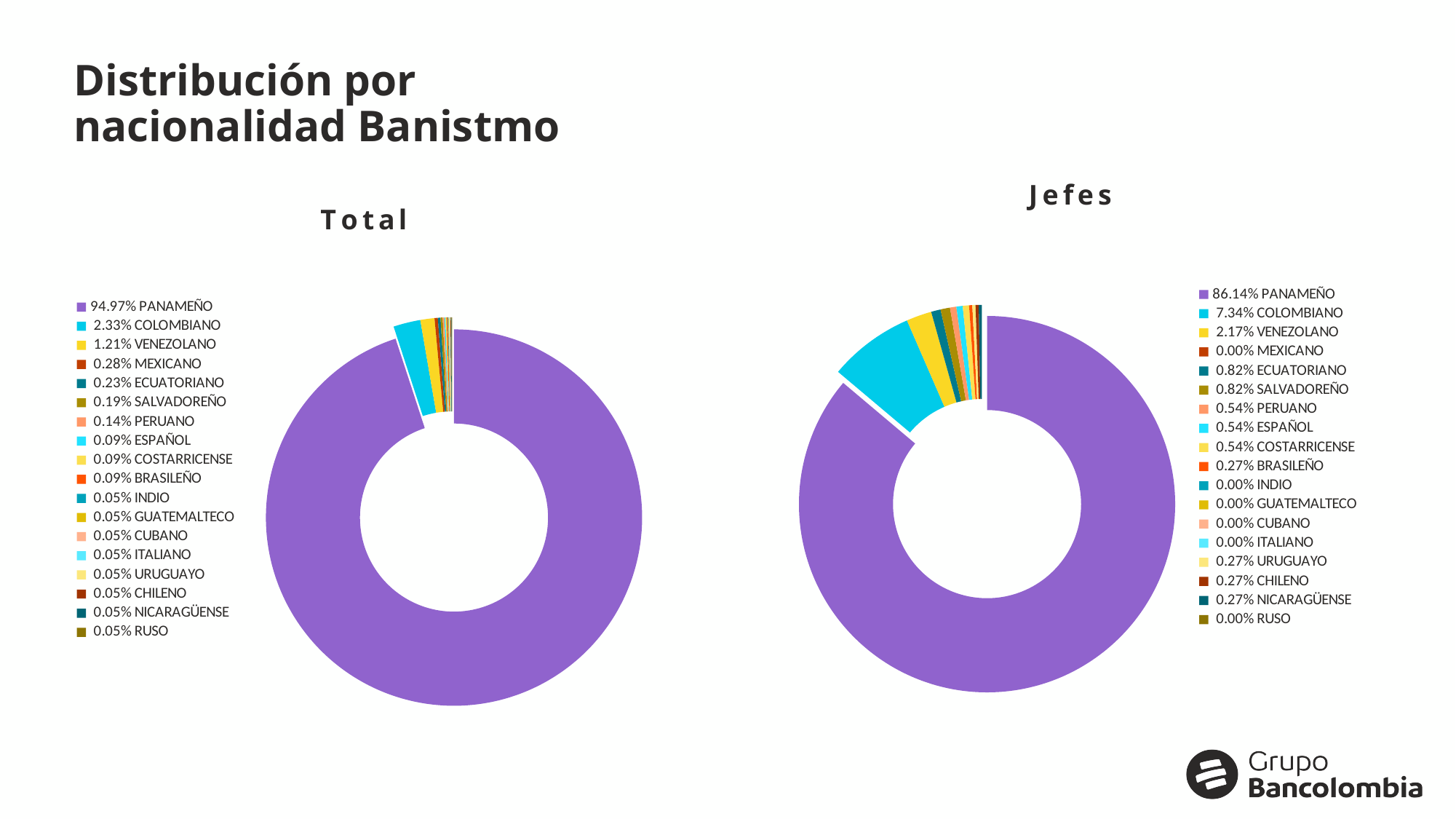
What is the title of the chart on the right side of the slide? Jefes In the "Jefes" chart, what is the value for MEXICANO? 0.00% In the "Total" chart, what is the value for VENEZOLANO? 1.21% Which is larger: the COLOMBIANO share in the "Total" chart or in the "Jefes" chart? Jefes In the "Jefes" chart, what is the value for ECUATORIANO? 0.82% In the "Total" chart, what share is PANAMEÑO? 94.97% In the "Jefes" chart, what share is COLOMBIANO? 7.34% What type of chart is used for the "Total" chart? Pie chart (donut) How many nationalities are listed in the legend of the "Total" chart? 18 In the "Jefes" chart, which nationality has the largest share? PANAMEÑO What is the difference between the PANAMEÑO share in the "Total" chart and in the "Jefes" chart? 8.83% In the "Total" chart, which nationality has the second-largest share? COLOMBIANO